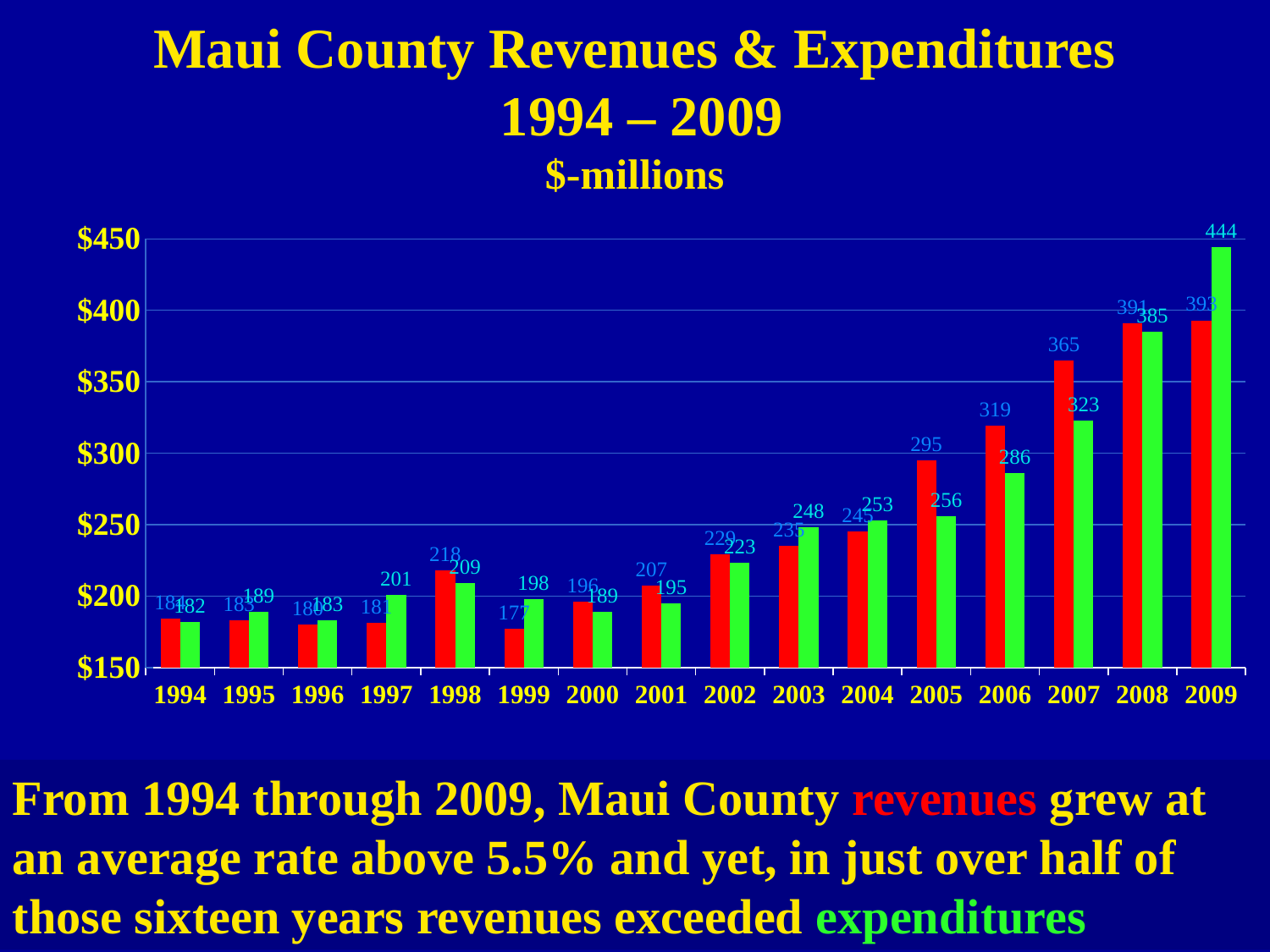
For 2006, which is larger: the red (revenues) bar or the green (expenditures) bar? red (revenues) What is the value of the green (expenditures) bar for 1999? 198 What unit is stated under the chart title? $-millions How many years are shown along the x axis of the chart? 16 What is the difference between the red bar (295) and the green bar (256) for 2005? 39 Do the red (revenues) bars generally rise or fall from 1994 to 2009? rise Which year has the tallest bar in the chart? 2009 What is the difference between the red bar (365) and the green bar (323) for 2007? 42 What is the value of the red (revenues) bar for 2007? 365 Is the value of the red (revenues) bar for 2008 greater or less than $350? greater What is the value of the green (expenditures) bar for 2009? 444 What kind of chart is shown on the slide? bar chart